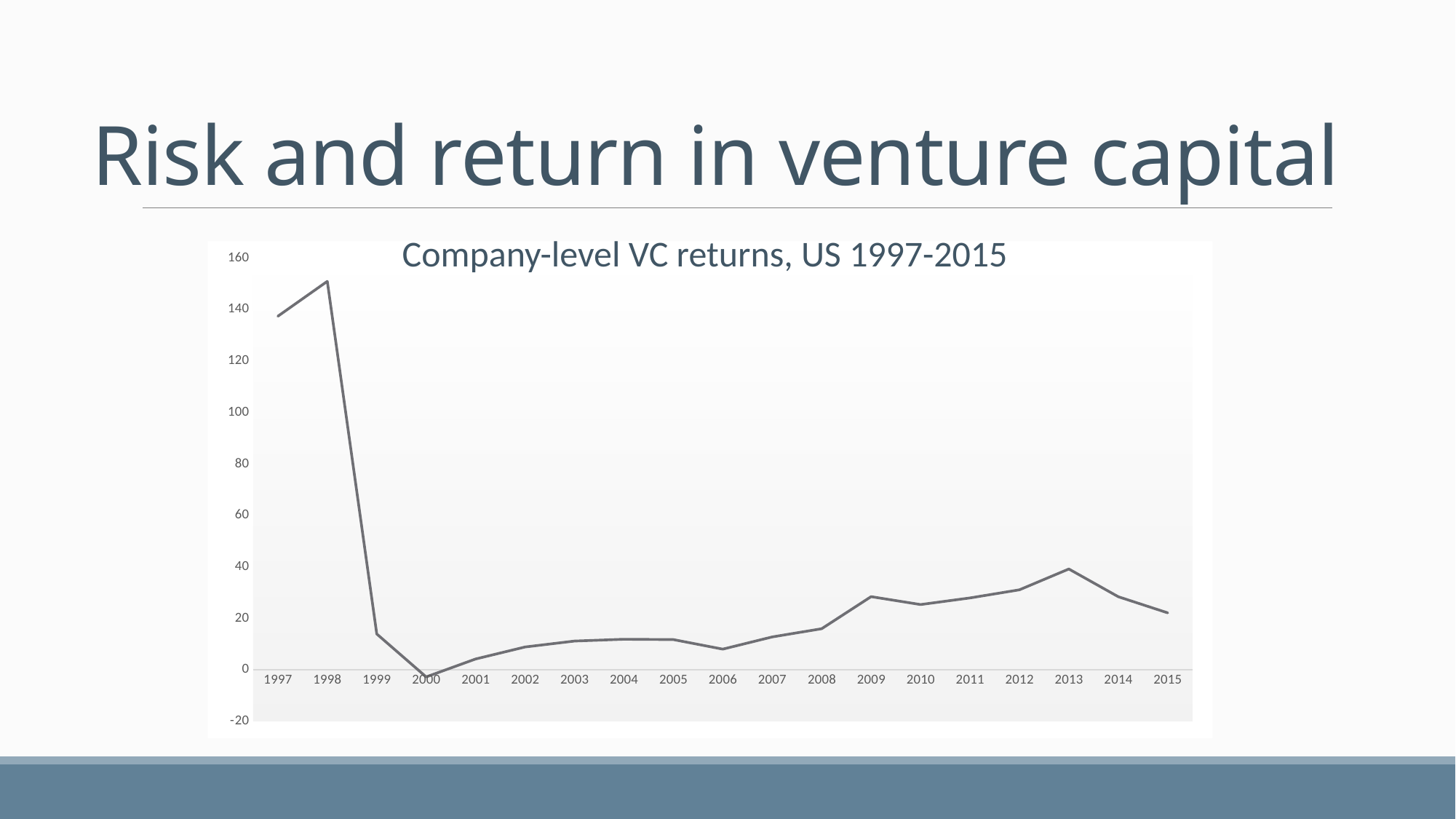
Is the value for 1997 greater or less than 120? greater Is the value for 1999 greater or less than 40? less What is the title of the chart? Company-level VC returns, US 1997-2015 Which year has the larger value, 2005 or 2013? 2013 What kind of chart is shown on the slide? line chart Which year has the lowest company-level VC return? 2000 Which year has the larger value, 1997 or 1999? 1997 Do the values rise or fall from 1998 to 2000? fall Which year has the highest company-level VC return? 1998 How many years are plotted on the x axis of the chart? 19 Is the value for 2006 greater or less than 20? less